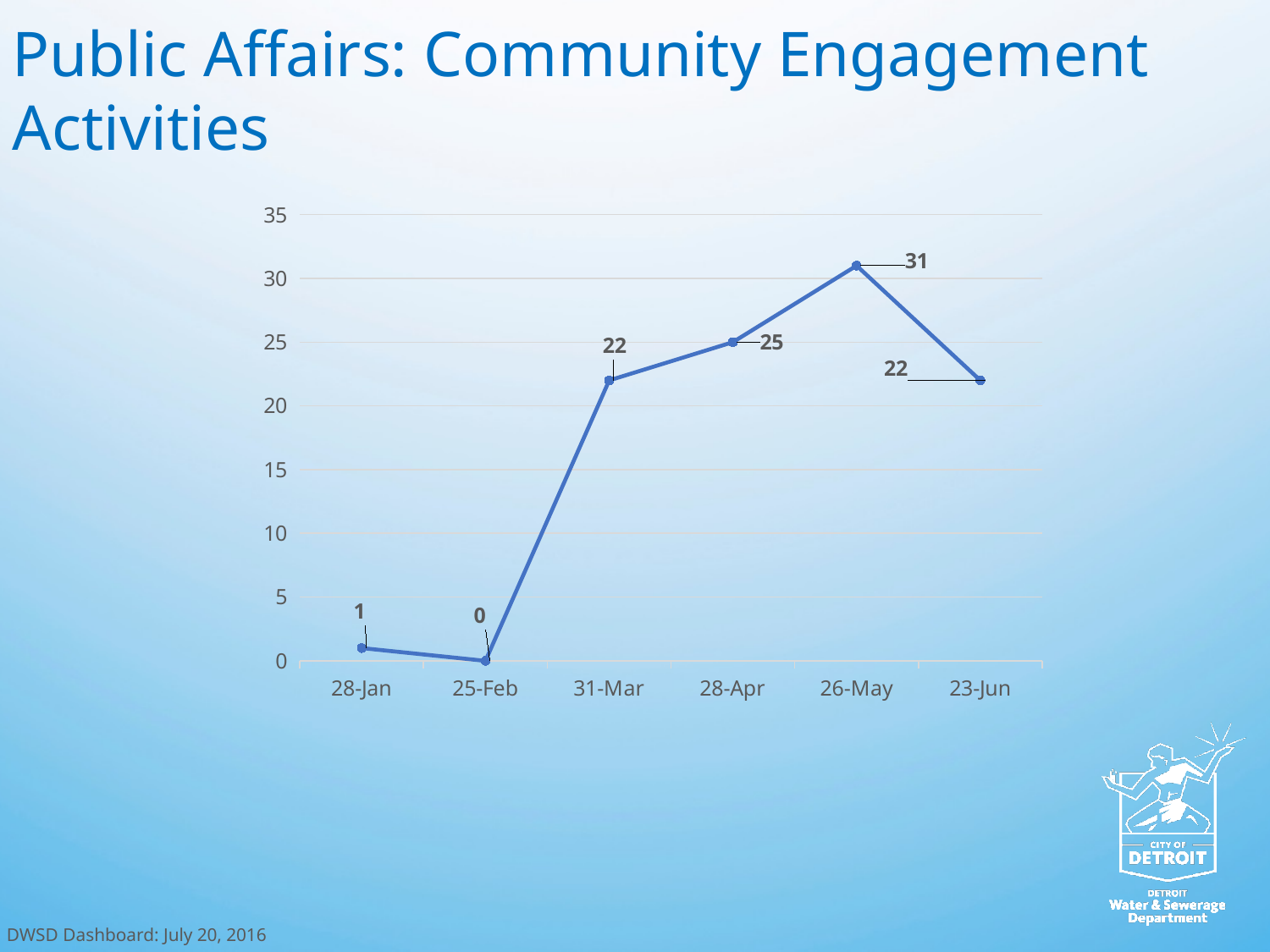
What is the value for 26-May? 31 Which is larger, the value for 28-Apr or the value for 31-Mar? 28-Apr What is the value for 31-Mar? 22 How many data points are plotted on the chart? 6 What kind of chart is shown on the slide? line chart Is the value for 28-Jan greater or less than 5? less Do the values rise or fall from 25-Feb to 26-May? rise What is the difference between the values for 26-May and 23-Jun? 9 Which date has the highest value? 26-May What is the value for 25-Feb? 0 Which date has the lowest value? 25-Feb What is the value for 28-Apr? 25